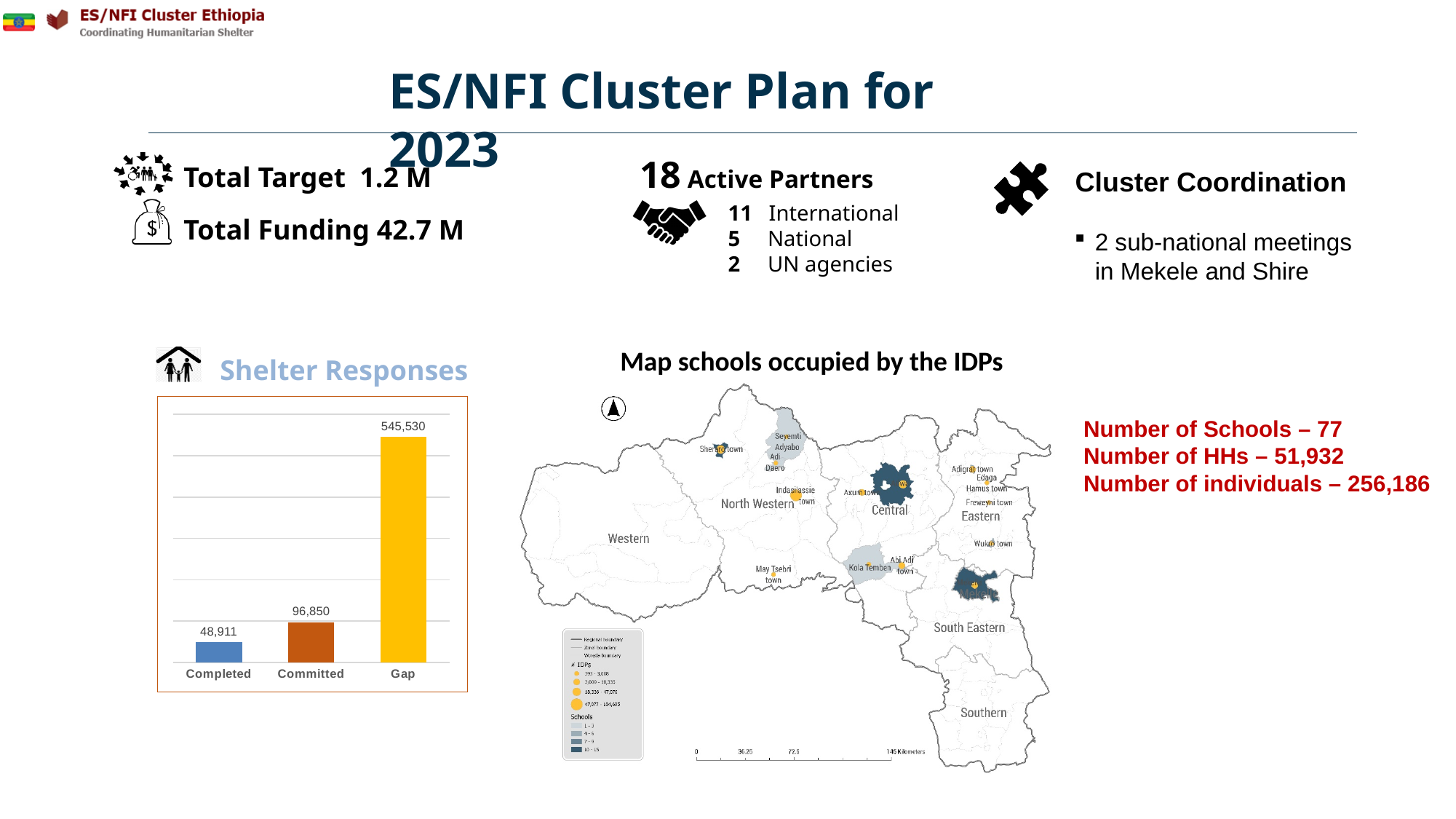
What is the value of the Gap bar in the Shelter Responses chart? 545,530 Which category has the highest value in the Shelter Responses chart? Gap Which category has the lowest value in the Shelter Responses chart? Completed What type of chart is the Shelter Responses chart? Bar chart What is the value of the Completed bar in the Shelter Responses chart? 48,911 In the Shelter Responses chart, what is the difference between the Gap and Committed values? 448,680 How many categories are shown in the Shelter Responses chart? 3 Do the values in the Shelter Responses chart rise or fall from left to right? Rise In the Shelter Responses chart, which is larger: Completed or Committed? Committed What is the value of the Committed bar in the Shelter Responses chart? 96,850 In the Shelter Responses chart, what is the difference between the Committed and Completed values? 47,939 What colour is the Gap bar in the Shelter Responses chart? Yellow